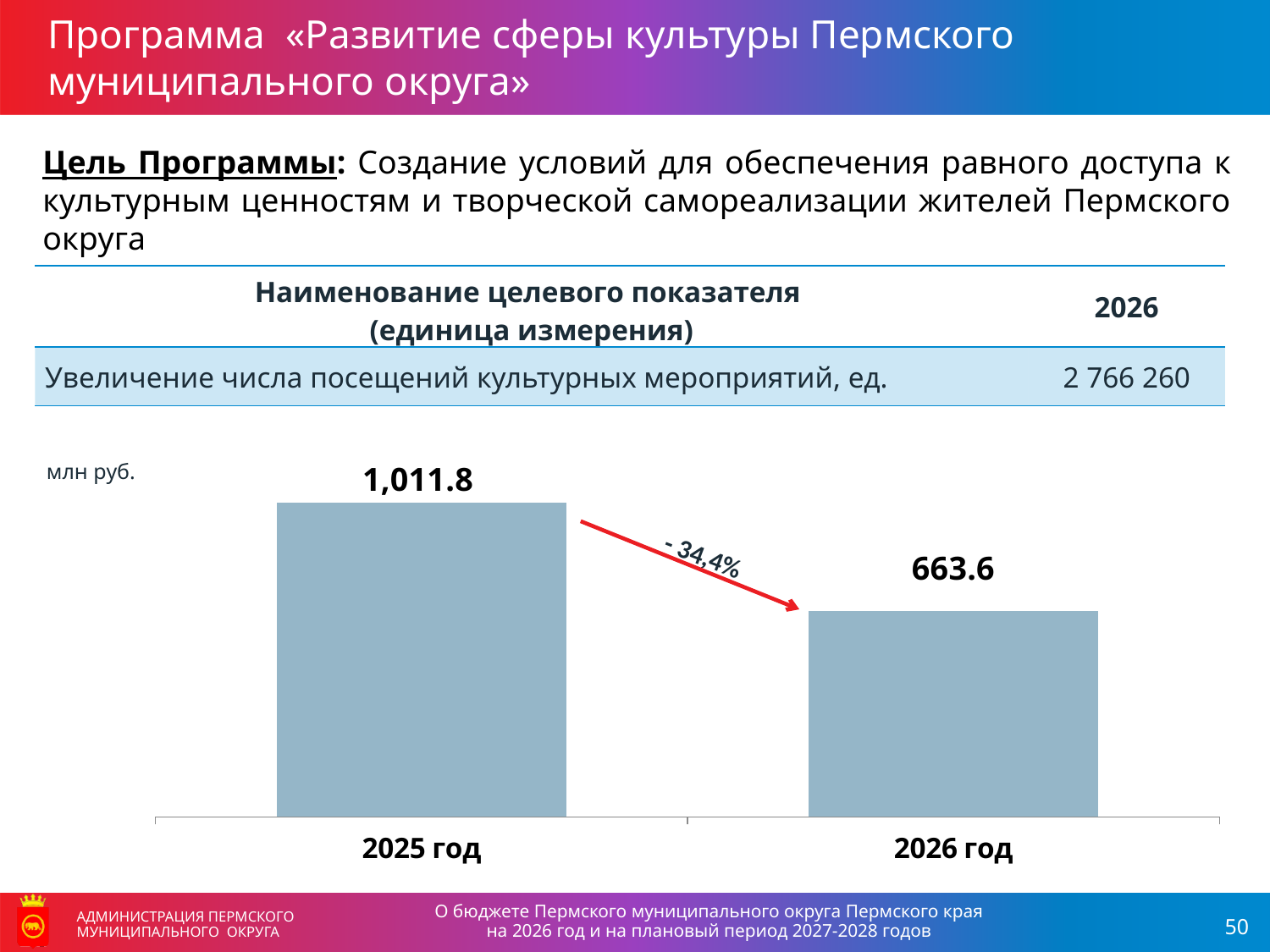
How many categories are shown in the chart? 2 What percentage change is shown on the arrow between the two bars? - 34,4% Which year has the highest value in the chart? 2025 год What is the value for 2025 год in the chart? 1,011.8 Which is larger, the value for 2025 год or for 2026 год? 2025 год What is the difference between the values for 2025 год and 2026 год? 348.2 What kind of chart is shown on the slide? bar chart Which year has the lowest value in the chart? 2026 год What is the value for 2026 год in the chart? 663.6 What unit of measurement is indicated for the chart? млн руб. Do the values rise or fall from 2025 год to 2026 год? fall